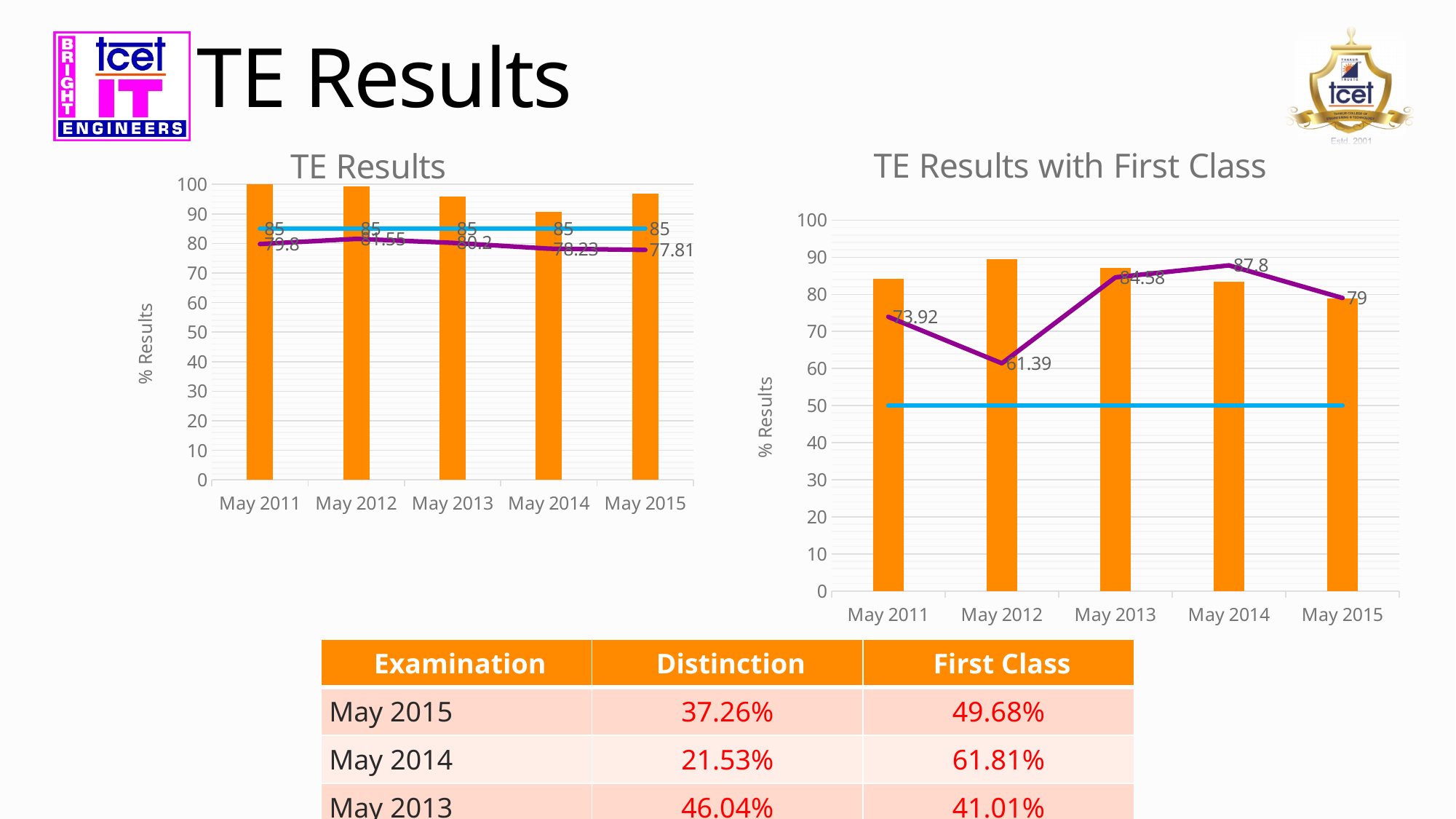
In the 'TE Results' chart, which is larger on the purple line: May 2011 or May 2012? May 2012 In the 'TE Results with First Class' chart, is the bar for May 2012 greater or less than 80? greater In the 'TE Results with First Class' chart, which month has the highest value on the purple line? May 2014 In the 'TE Results' chart, does the purple line rise or fall from May 2012 to May 2015? fall In the 'TE Results with First Class' chart, what is the difference between the purple line values for May 2014 and May 2012? 26.41 In the 'TE Results' chart, is the bar for May 2014 greater or less than 80? greater How many months are shown on the x axis of the 'TE Results' chart? 5 In the 'TE Results with First Class' chart, what value does the purple line show for May 2012? 61.39 In the 'TE Results with First Class' chart, which month has the lowest value on the purple line? May 2012 What kind of chart is the 'TE Results' chart? Bar chart with line overlays In the 'TE Results' chart, what value does the purple line show for May 2015? 77.81 In the 'TE Results' chart, what value does the blue line show for May 2013? 85